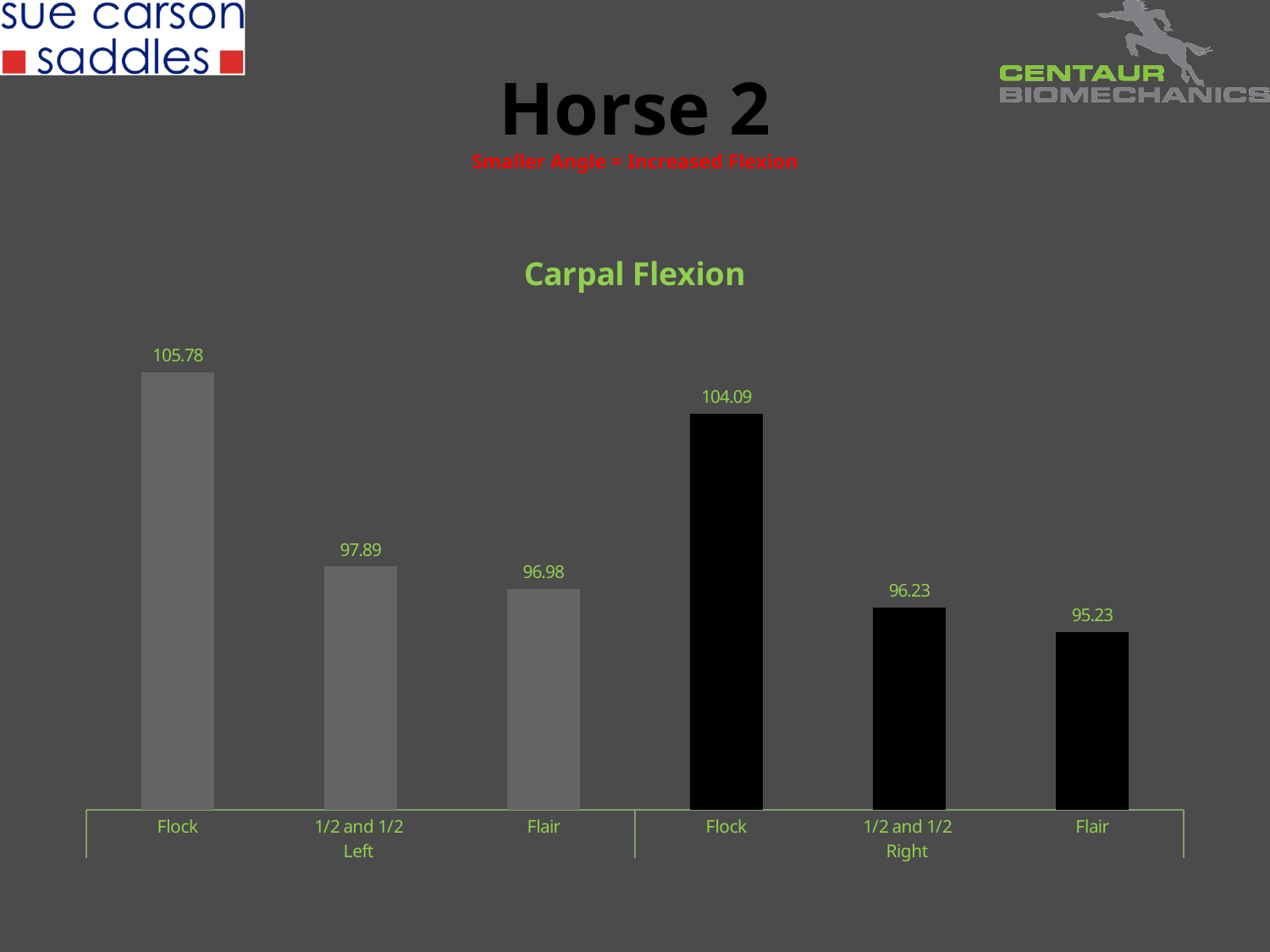
What kind of chart is shown on the slide? bar chart How many bars are plotted in the chart? 6 Which bar has the highest value in the chart? Flock (Left) What is the Carpal Flexion value for Flock on the Right side? 104.09 Which is larger, the 1/2 and 1/2 value on the Left or the 1/2 and 1/2 value on the Right? Left What is the difference between the Flock values for Left and Right? 1.69 What is the difference between the Flock and Flair values on the Left side? 8.80 What is the Carpal Flexion value for Flock on the Left side? 105.78 What is the Carpal Flexion value for Flair on the Right side? 95.23 Which bar has the lowest value in the chart? Flair (Right) What is the title of the chart? Carpal Flexion What is the Carpal Flexion value for 1/2 and 1/2 on the Left side? 97.89